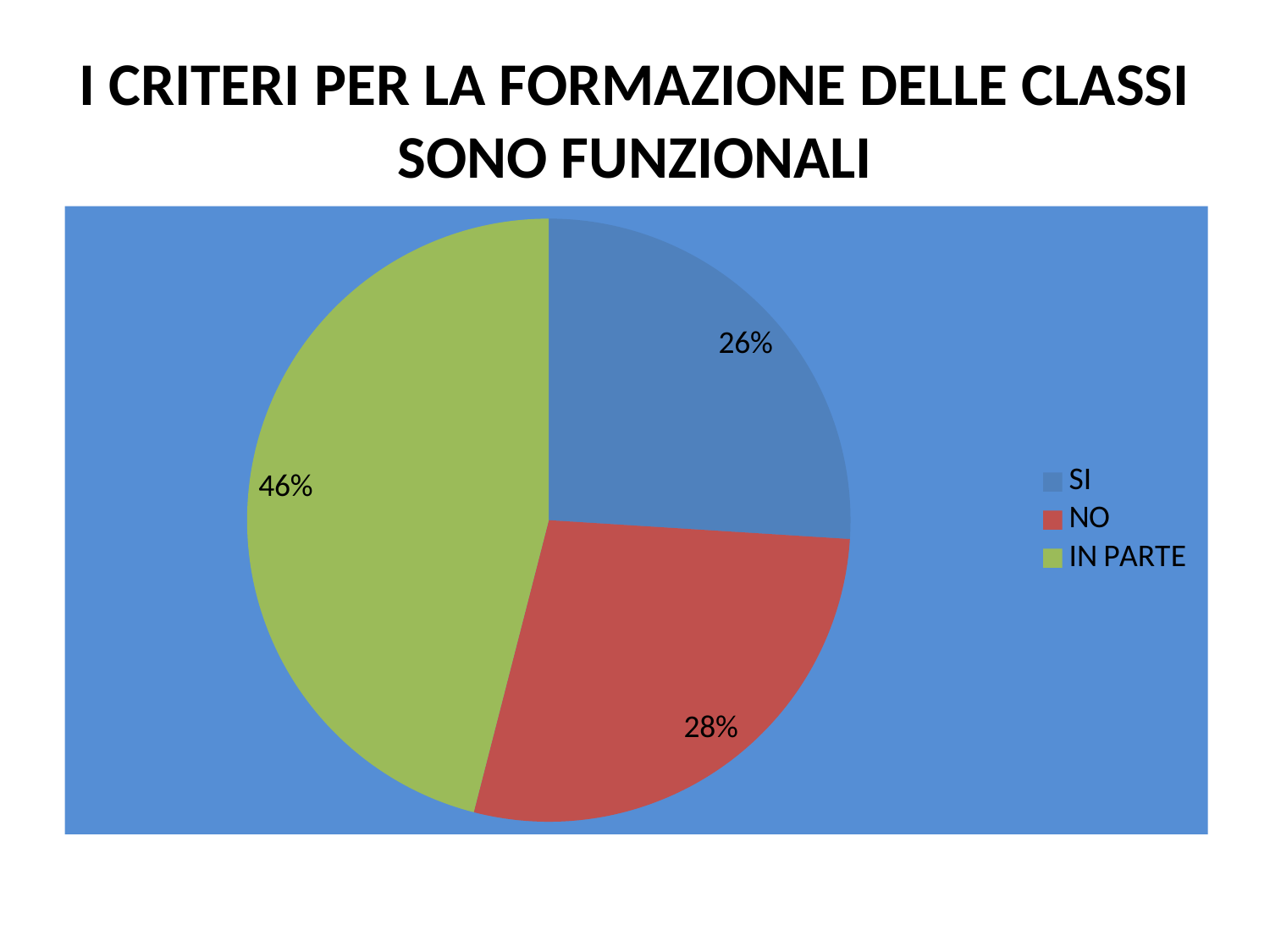
What is the difference in percentage points between the IN PARTE slice and the NO slice? 18 What share of the pie does the NO slice represent? 28% What share of the pie does the SI slice represent? 26% What kind of chart is shown on the slide? Pie chart What share of the pie does the IN PARTE slice represent? 46% Which category has the largest slice of the pie? IN PARTE What is the title of the slide? I CRITERI PER LA FORMAZIONE DELLE CLASSI SONO FUNZIONALI Which is larger, the SI slice or the IN PARTE slice? IN PARTE Which category has the smallest slice of the pie? SI How many categories does the pie chart show? 3 What colour is the IN PARTE slice in the pie chart? Green What is the difference in percentage points between the NO slice and the SI slice? 2